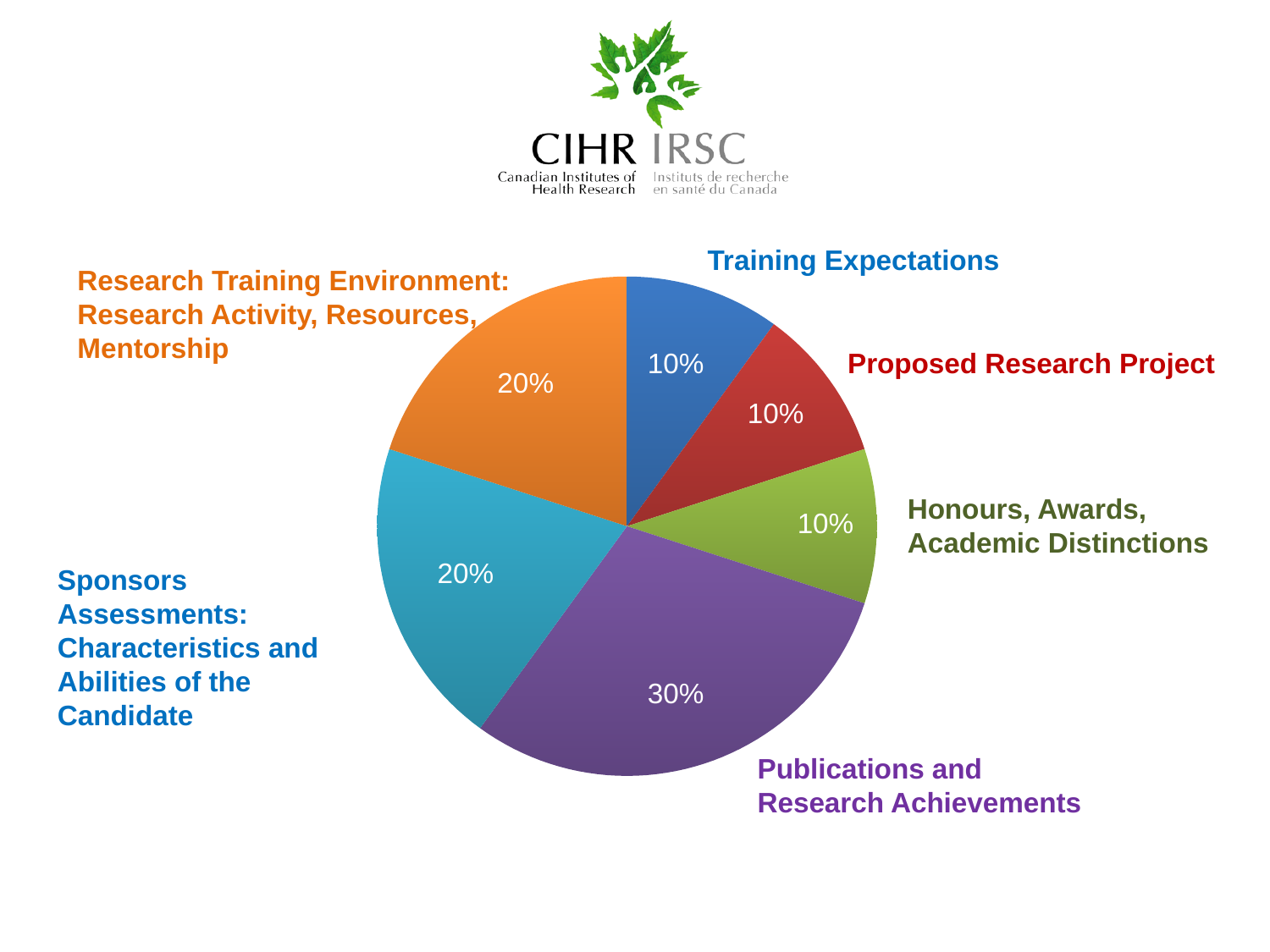
What colour is the slice for Publications and Research Achievements? purple How many slices does the pie chart have? 6 What share of the pie does Sponsors Assessments: Characteristics and Abilities of the Candidate have? 20% What share of the pie does Training Expectations have? 10% What share of the pie does Publications and Research Achievements have? 30% Which is larger, the share for Sponsors Assessments or the share for Proposed Research Project? Sponsors Assessments What is the difference between the share for Publications and Research Achievements and the share for Training Expectations? 20% Which category has the largest slice of the pie? Publications and Research Achievements What kind of chart is shown on the slide? pie chart